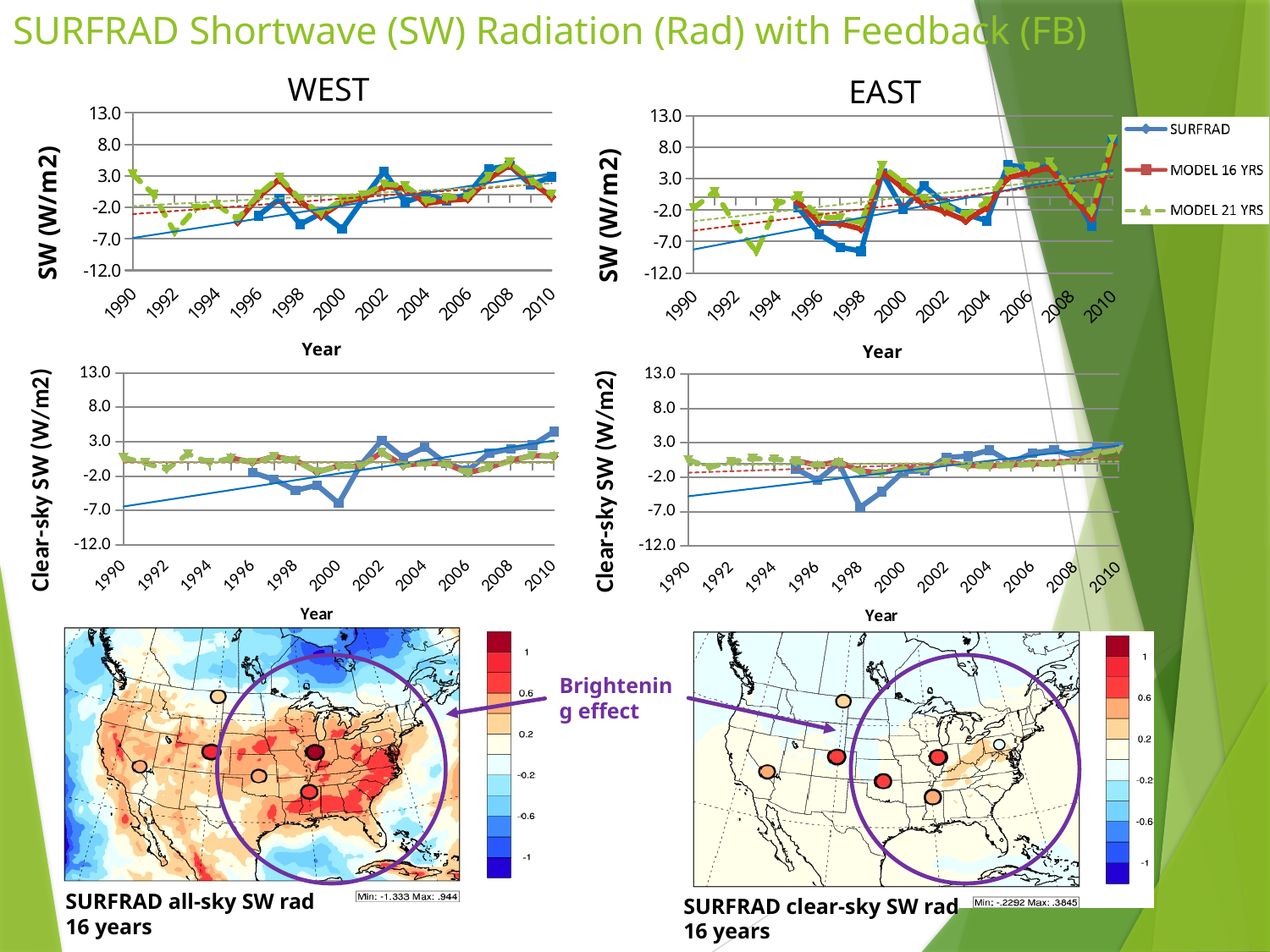
In the EAST Clear-sky SW (W/m2) chart, is the SURFRAD value for 1998 greater or less than -2.0? less In the WEST SW (W/m2) chart, is the SURFRAD value for 2000 greater or less than -2.0? less What is the highest value shown on the y axis of the WEST SW (W/m2) chart? 13.0 Which series in the legend is drawn with a dashed green line and triangle markers? MODEL 21 YRS How many series does the legend list for the line charts? 3 What is the label of the x axis on the WEST SW (W/m2) chart? Year How many year labels are shown on the x axis of the EAST SW (W/m2) chart? 11 In the EAST SW (W/m2) chart, is the SURFRAD value for 1998 greater or less than -2.0? less What kind of chart is the WEST SW (W/m2) chart at the top left? line chart In the WEST Clear-sky SW (W/m2) chart, does the SURFRAD series generally rise or fall from 2000 to 2010? rise